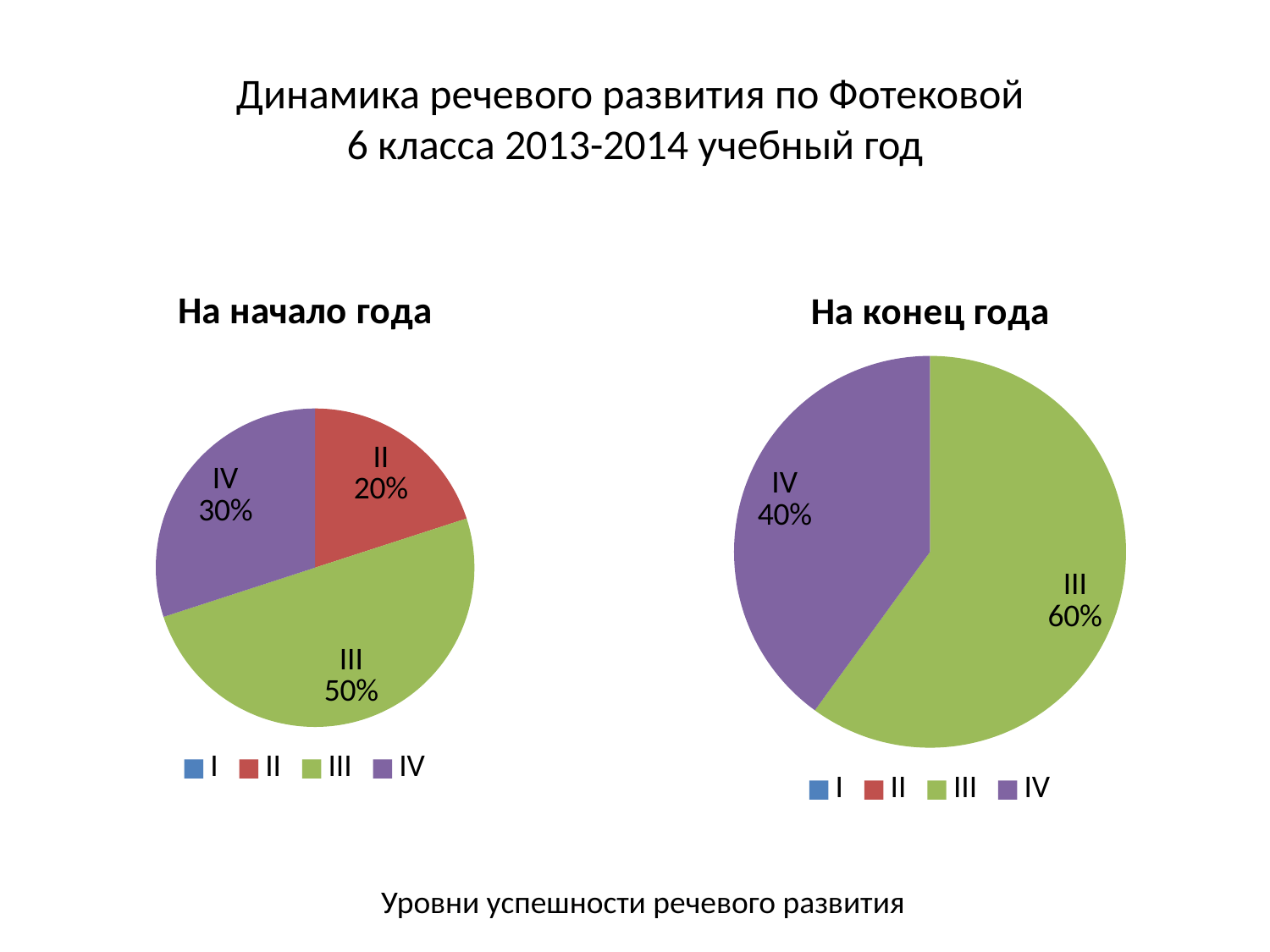
In the "На начало года" chart, which labelled level has the smallest slice? II In the "На начало года" chart, which level has the largest slice? III In the "На начало года" chart, which is larger: the share of level IV or level II? IV In the "На начало года" chart, what is the difference between the shares of level IV and level II? 10% What type of chart is "На начало года"? Pie chart How many entries does the legend of the "На конец года" chart list? 4 In the "На конец года" chart, what share does level IV have? 40% In the "На конец года" chart, what share does level III have? 60% In the "На конец года" chart, which level has the largest slice? III In the "На начало года" chart, what share does level III have? 50% In the "На начало года" chart, what share does level II have? 20% In the "На конец года" chart, what is the difference between the shares of level III and level IV? 20%